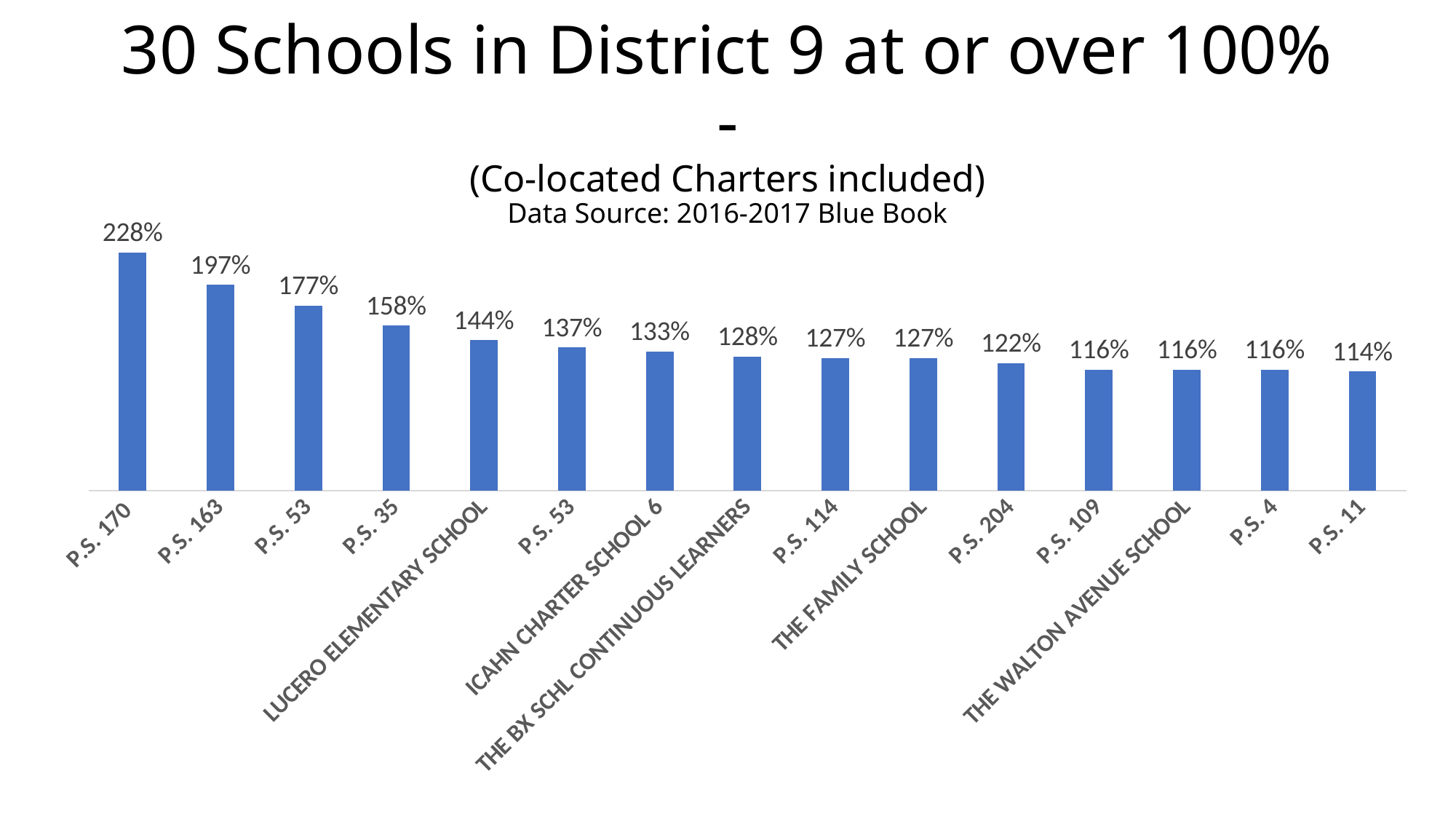
What is the value for Icahn Charter School 6? 133% Which school has the highest value on the chart? P.S. 170 What is the difference between the values for P.S. 170 and P.S. 163? 31% What is the value for The Walton Avenue School? 116% What is the difference between the values for P.S. 35 and P.S. 204? 36% What is the value for P.S. 170? 228% What is the value for Lucero Elementary School? 144% What kind of chart is shown on the slide? Bar chart How many schools are shown on the chart? 15 Which is larger, the value for P.S. 163 or the value for The Family School? P.S. 163 Which school has the lowest value on the chart? P.S. 11 What data source is cited on the slide? 2016-2017 Blue Book